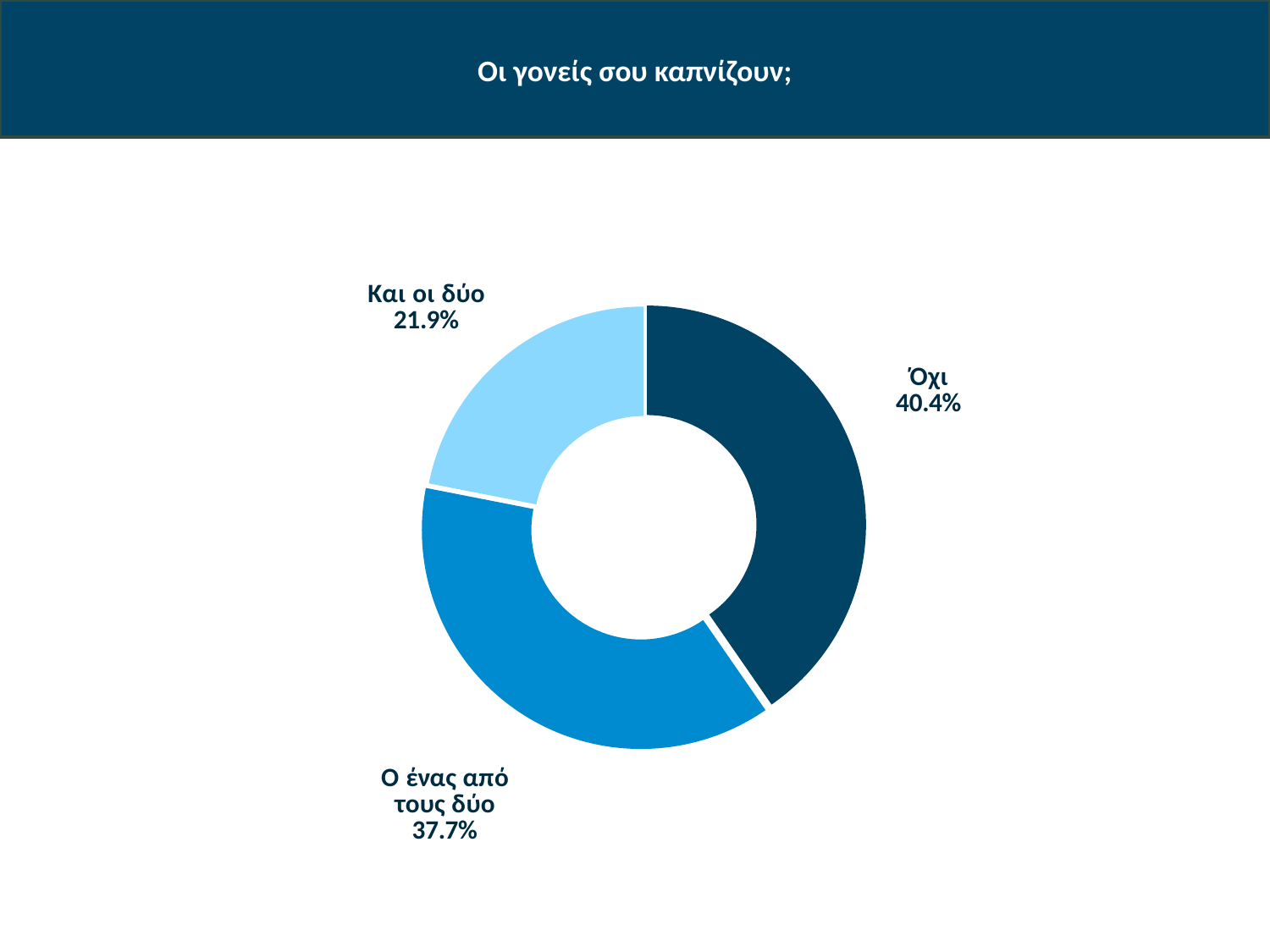
How many categories are shown in the chart? 3 What percentage of respondents answered 'Όχι'? 40.4% Which is larger, the share for 'Όχι' or the share for 'Και οι δύο'? Όχι Which category has the smallest share of the chart? Και οι δύο What percentage of respondents answered 'Ο ένας από τους δύο'? 37.7% What is the difference in percentage points between 'Ο ένας από τους δύο' and 'Και οι δύο'? 15.8 What is the title of the slide? Οι γονείς σου καπνίζουν; What colour is the slice for 'Και οι δύο'? Light blue What percentage of respondents answered 'Και οι δύο'? 21.9% What kind of chart is shown on the slide? Doughnut (pie) chart What is the difference in percentage points between 'Όχι' and 'Ο ένας από τους δύο'? 2.7 Which category has the largest share of the chart? Όχι